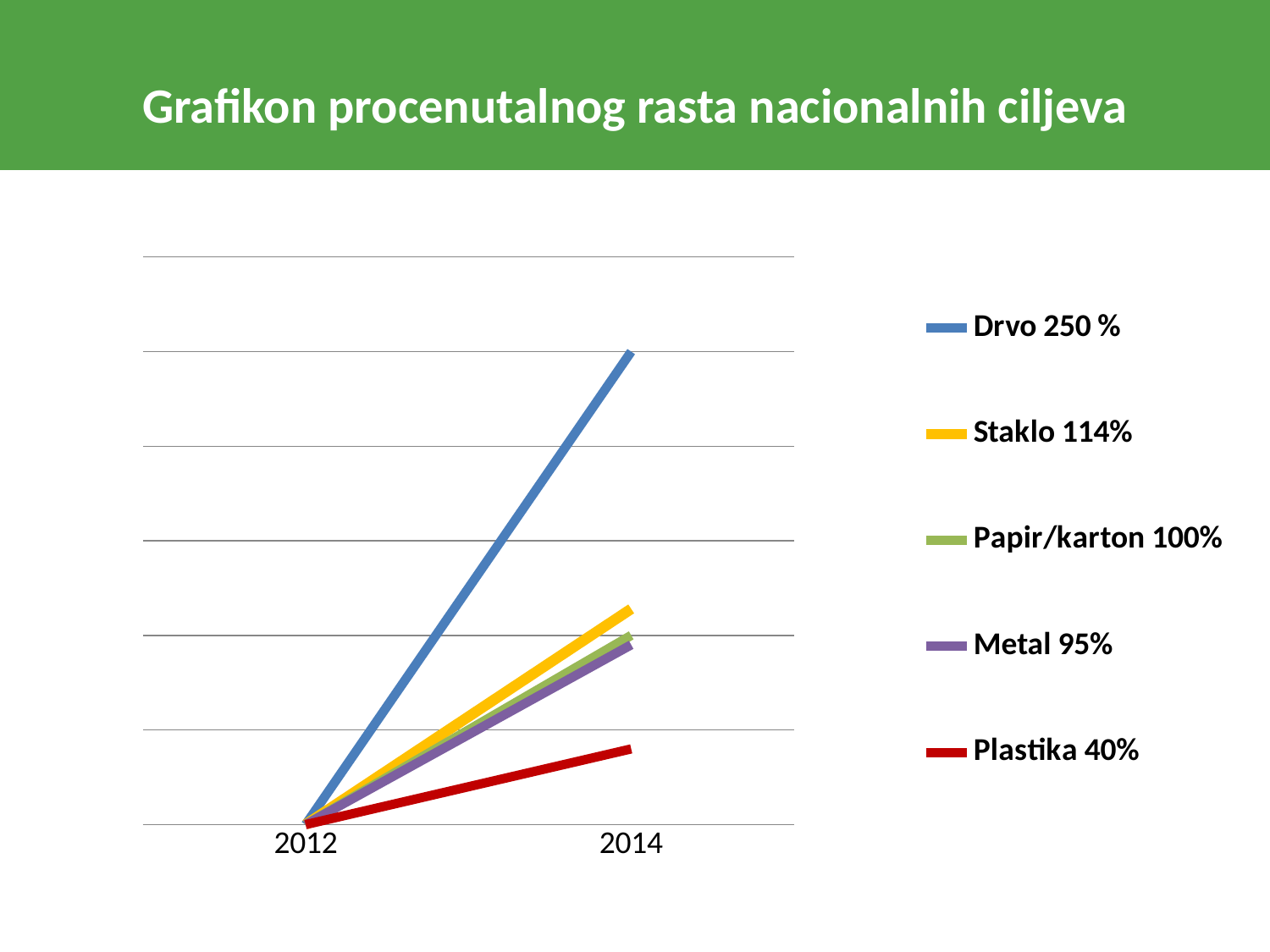
How many series does the legend list? 5 What kind of chart is shown on the slide? line chart What is the legend entry for the blue line? Drvo 250 % How many points are on the x axis of the chart? 2 What is the title of the slide? Grafikon procenutalnog rasta nacionalnih ciljeva In 2014, which is higher: the Drvo line or the Staklo line? Drvo Do the lines rise or fall from 2012 to 2014? rise Which series has the lowest value in 2014? Plastika 40% In 2014, which is higher: the Staklo line or the Plastika line? Staklo Which series reaches the highest value in 2014? Drvo 250 % In 2014, which is higher: the Staklo line or the Metal line? Staklo